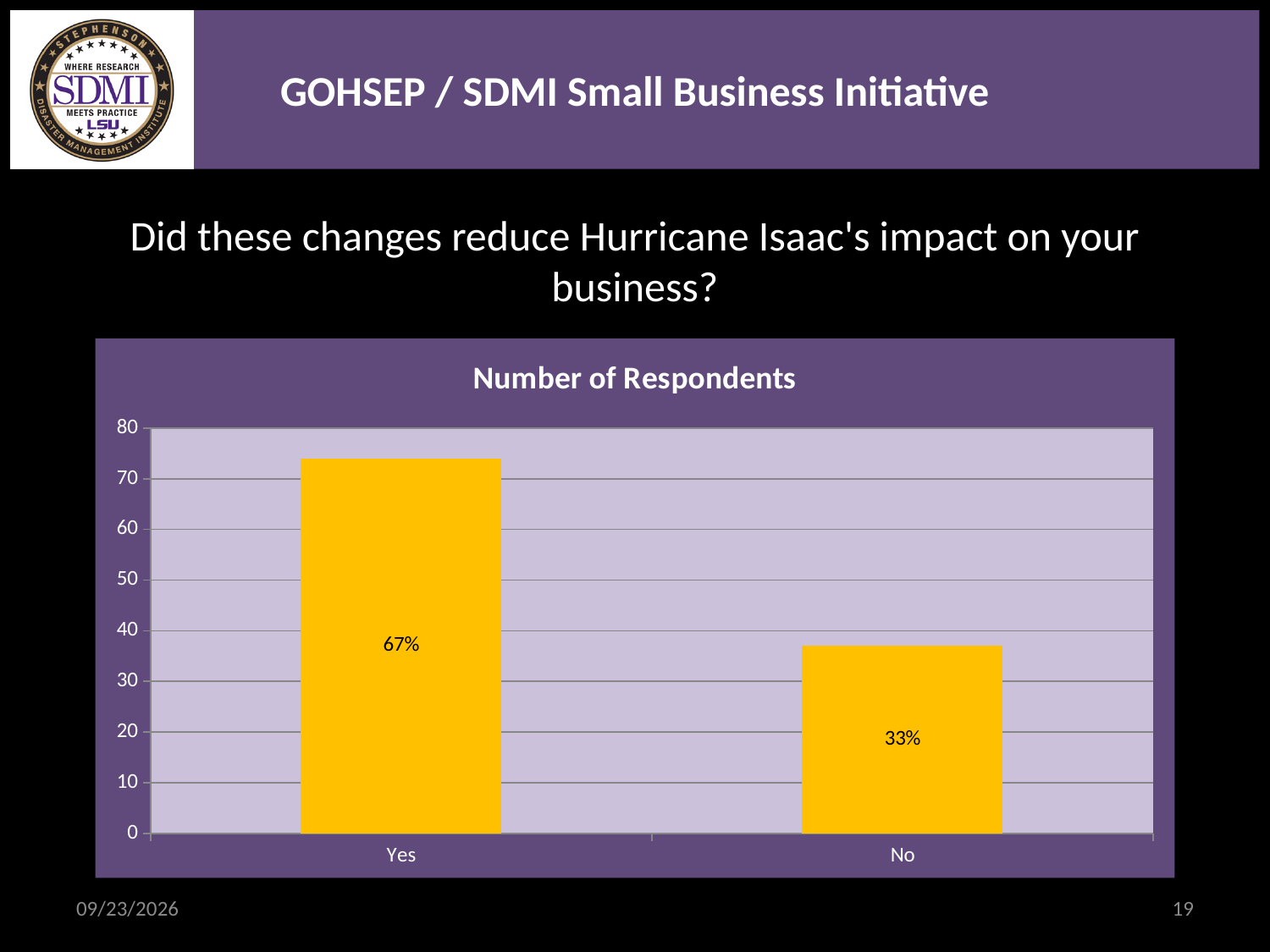
Is the value for 'No' greater or less than 40? less Which category has the lowest bar? No Which category has the highest bar? Yes What is the difference between the percentage labels on the 'Yes' and 'No' bars? 34% How many categories are shown on the x axis? 2 What is the title of the chart? Number of Respondents What percentage label is shown on the 'No' bar? 33% What kind of chart is shown on the slide? Bar chart What percentage label is shown on the 'Yes' bar? 67% Is the value for 'Yes' greater or less than 70? greater Is the value for 'No' greater or less than 30? greater Which bar is taller, 'Yes' or 'No'? Yes